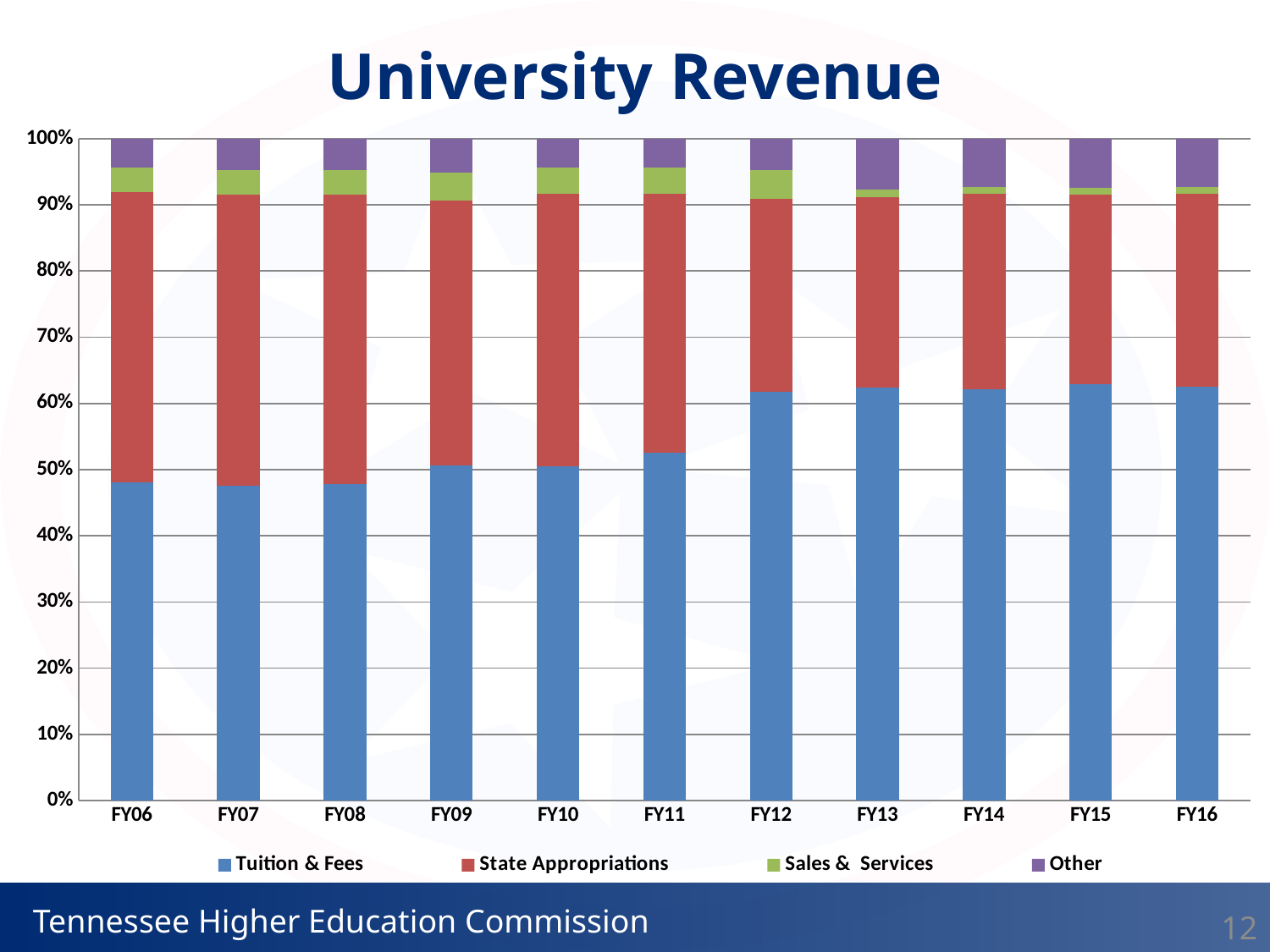
Is the Tuition & Fees share for FY16 greater or less than 60%? greater How many fiscal years are shown on the x axis? 11 Is the Tuition & Fees share for FY12 greater or less than 60%? greater What kind of chart is shown on the slide? bar chart Which series is shown in blue in the legend? Tuition & Fees What is the title of the chart? University Revenue Does the Tuition & Fees share generally rise or fall from FY06 to FY16? rise Is the Tuition & Fees share for FY11 greater or less than 50%? greater Which year has the larger Tuition & Fees share, FY06 or FY16? FY16 What does each stacked bar total? 100% How many series does the legend list? 4